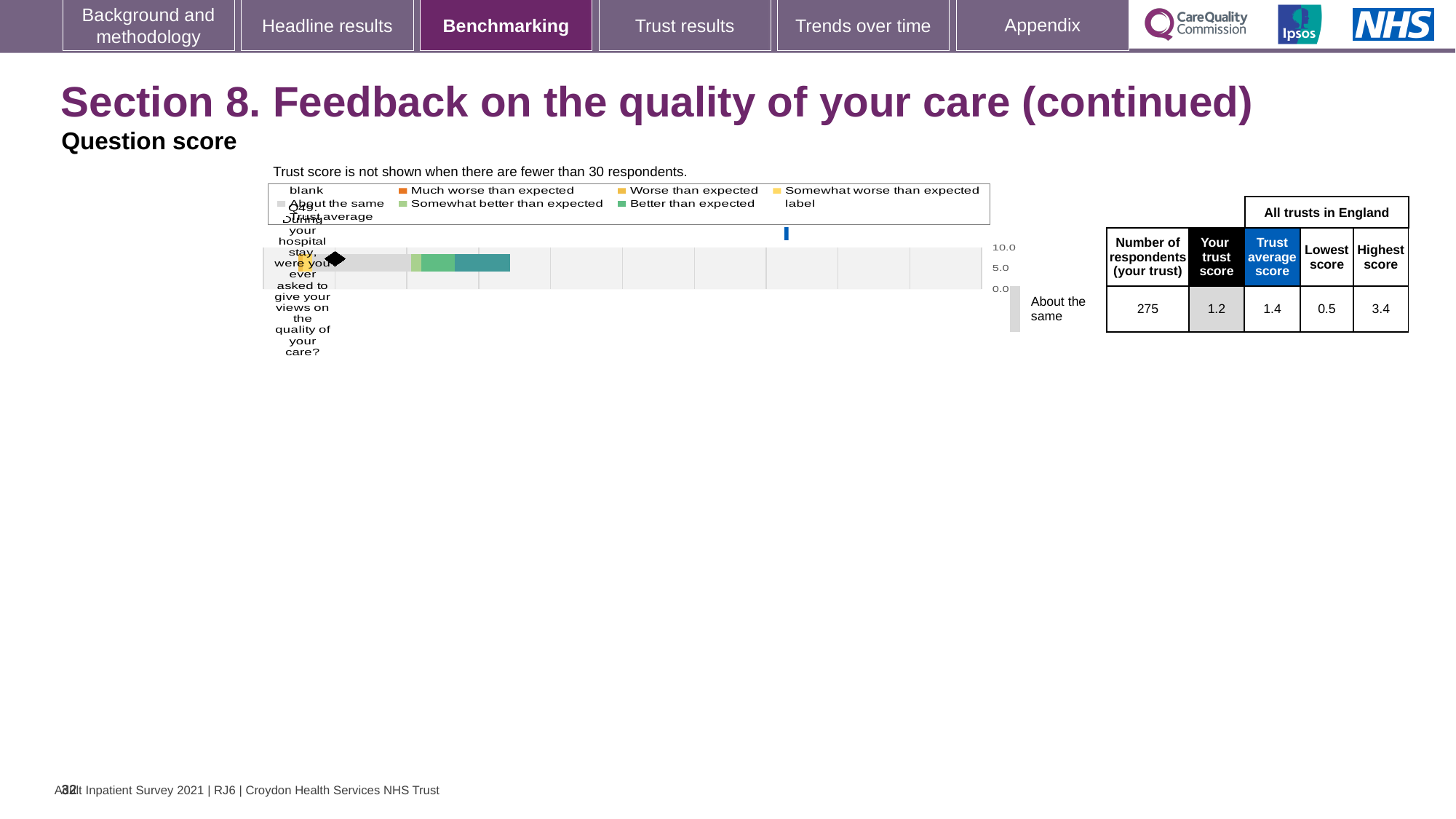
What is the highest value shown on the chart's score axis? 10.0 What is the trust average score for Q49? 1.4 What is the lowest score among all trusts in England for Q49? 0.5 Which benchmark category is your trust's Q49 result placed in? About the same What is the highest score among all trusts in England for Q49? 3.4 What kind of chart is used to show the Q49 benchmarking result? bar chart What is the difference between the highest and lowest scores for Q49 across all trusts in England? 2.9 Which is larger for Q49, your trust score or the trust average score? Trust average score How many survey questions are plotted on the chart? 1 What is the number of respondents for Q49 at your trust? 275 Is your trust score for Q49 greater or less than 5.0? less What is your trust score for Q49? 1.2